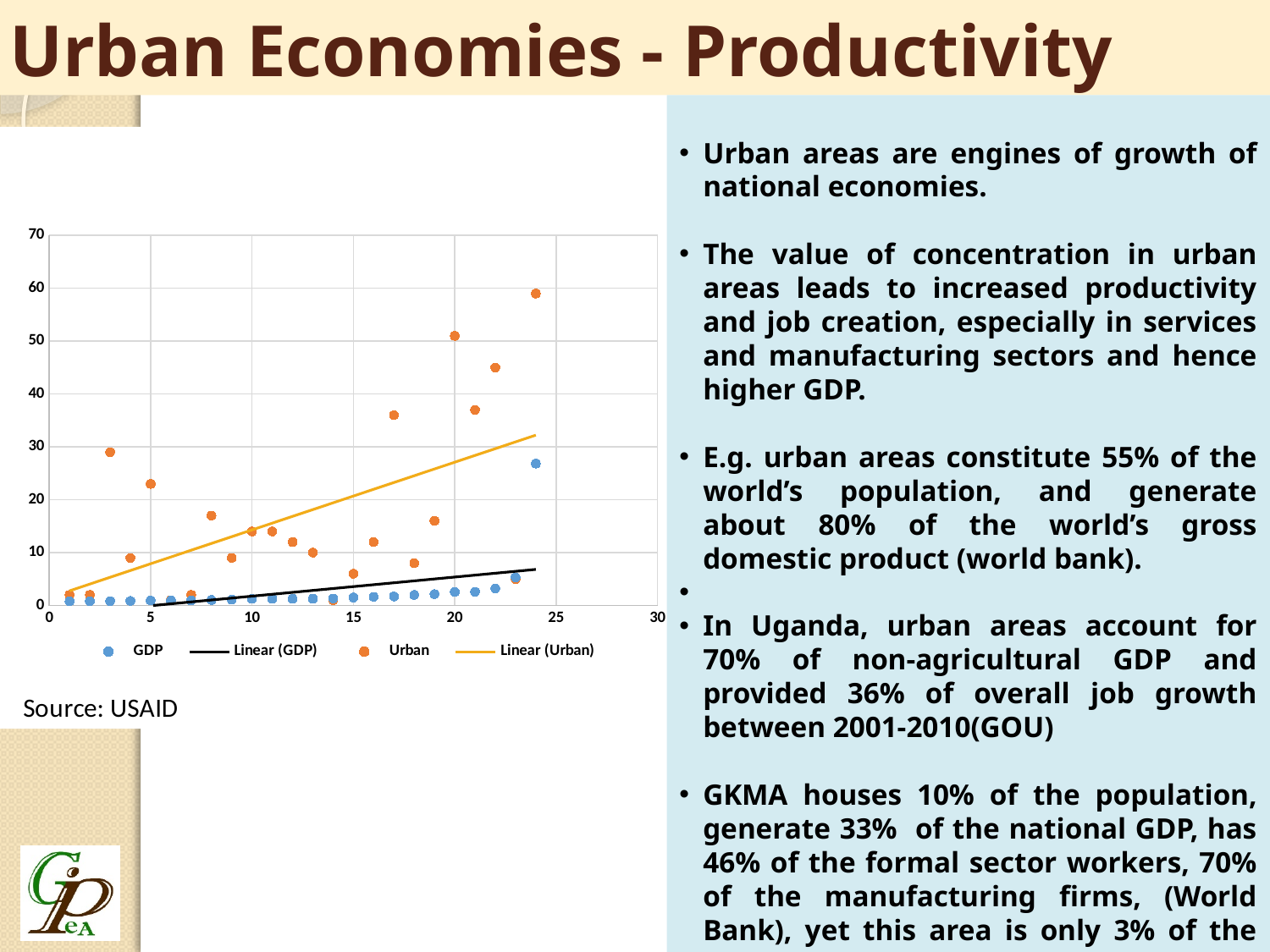
What source is cited below the chart? USAID Is the Urban value at x = 3 greater or less than 20? greater Is the Urban value at x = 24 greater or less than 50? greater Does the Linear (Urban) trend line rise or fall as x increases? Rises What colour are the Urban data points in the chart? Orange What kind of chart is shown on the slide? Scatter chart How many entries does the chart legend list? 4 Does the Linear (GDP) trend line rise or fall as x increases? Rises Is the GDP value at x = 24 greater or less than 20? greater At x = 24, which series has the larger value, GDP or Urban? Urban Which series, GDP or Urban, generally has the higher values across the chart? Urban